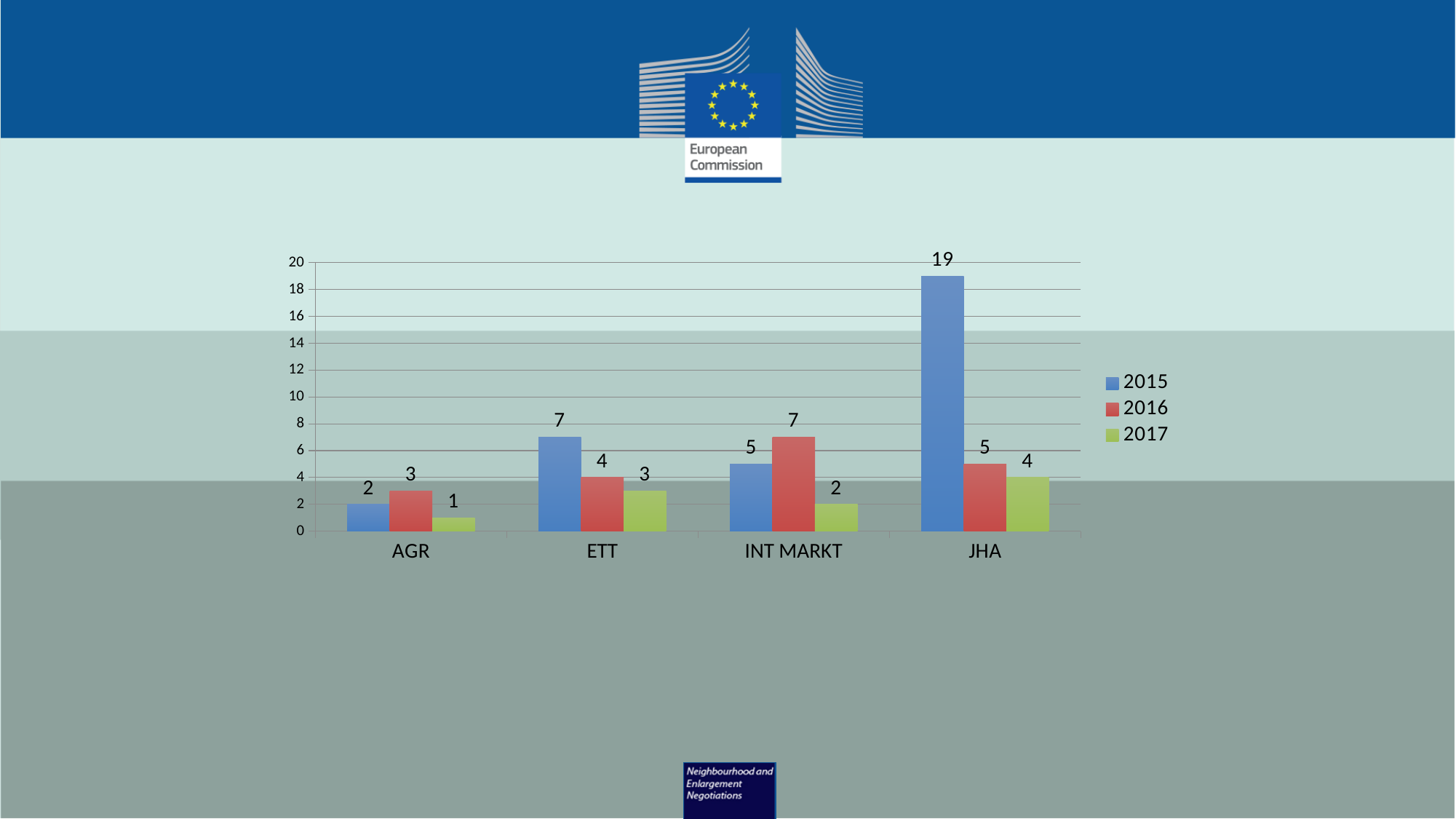
What is the value for AGR in 2017? 1 Which category has the highest value in 2015? JHA What is the value for JHA in 2015? 19 Which colour represents the 2017 series in the legend? Green What is the value for INT MARKT in 2016? 7 How many series does the legend list? 3 How many categories are shown on the x axis? 4 What is the value for ETT in 2016? 4 Which category has the lowest value in 2017? AGR Which is larger, the 2015 value for INT MARKT or the 2016 value for INT MARKT? 2016 What is the difference between the 2015 and 2017 values for JHA? 15 What kind of chart is shown on the slide? Bar chart